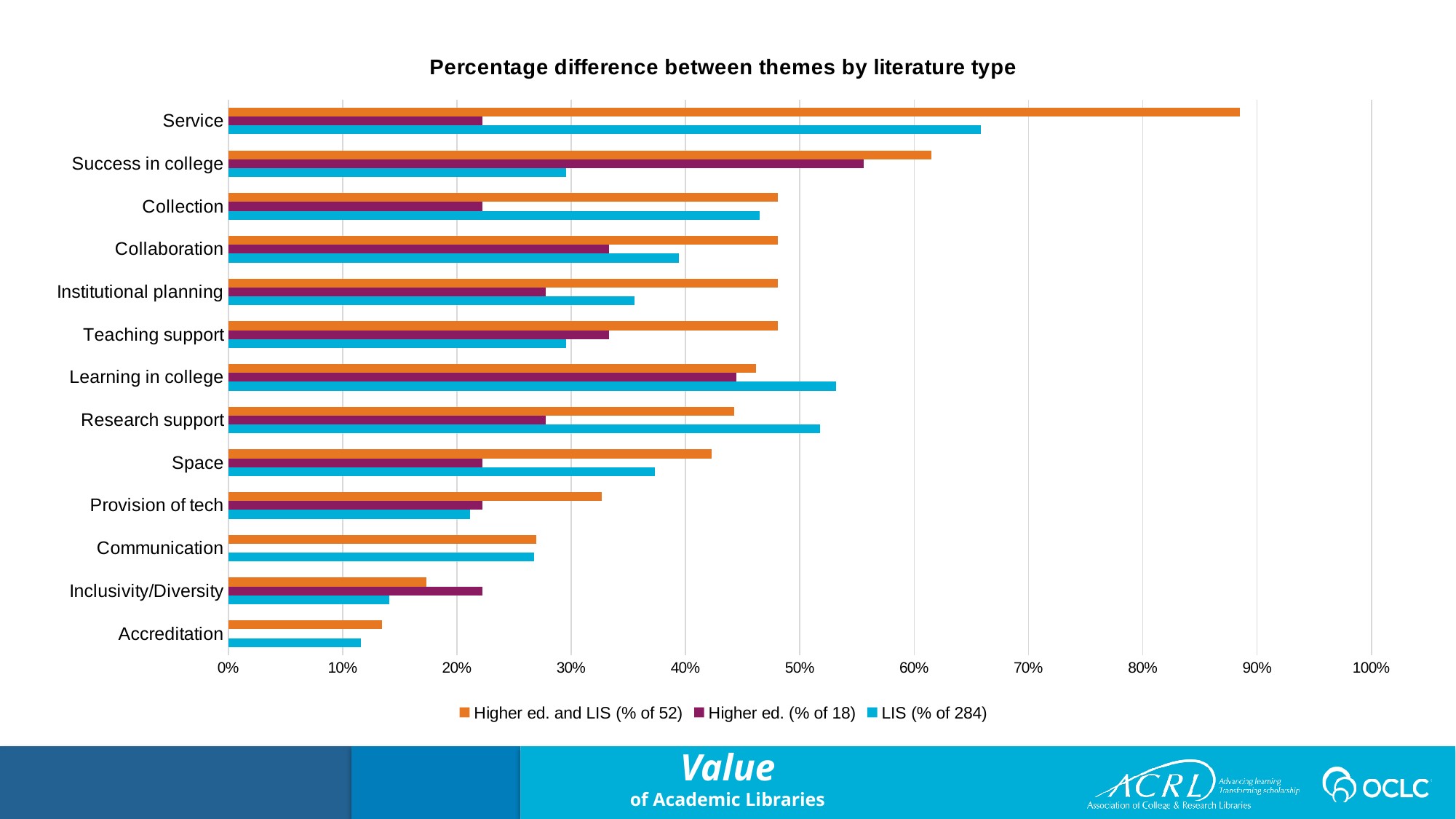
How many series does the legend list? 3 Which theme has the highest value for the Higher ed. and LIS (% of 52) series? Service How many themes (categories) are listed on the vertical axis? 13 Which theme has the lowest value for the LIS (% of 284) series? Accreditation Is the LIS (% of 284) value for Institutional planning greater or less than 40%? less Is the Higher ed. and LIS (% of 52) value for Accreditation greater or less than 20%? less Which theme has the highest value for the Higher ed. (% of 18) series? Success in college Is the Higher ed. and LIS (% of 52) value for Service greater or less than 80%? greater What is the title of the chart? Percentage difference between themes by literature type For Inclusivity/Diversity, which is larger: the Higher ed. (% of 18) value or the Higher ed. and LIS (% of 52) value? Higher ed. (% of 18) What kind of chart is shown on the slide? Bar chart For Learning in college, which is larger: the LIS (% of 284) value or the Higher ed. and LIS (% of 52) value? LIS (% of 284)